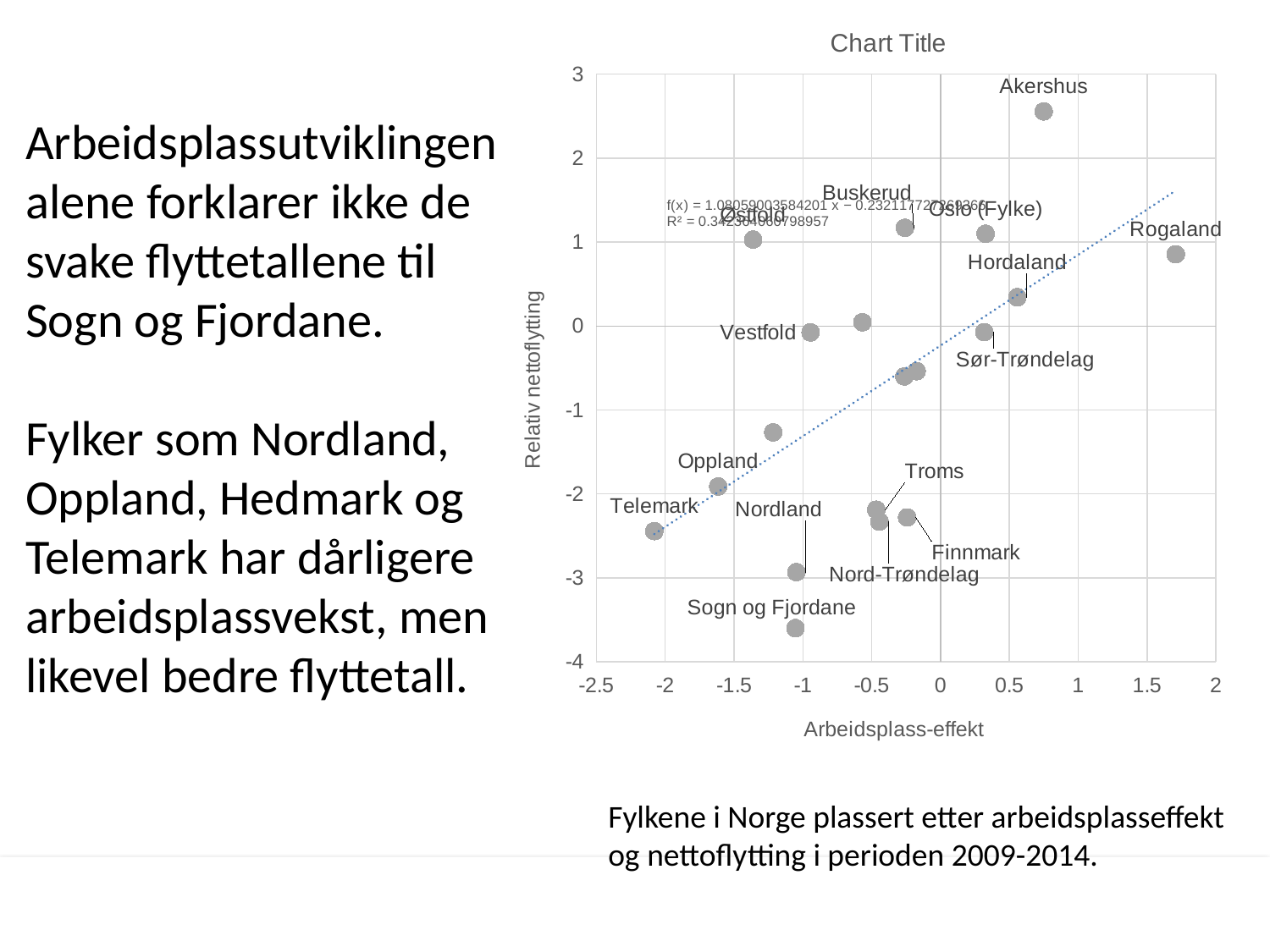
Which county has the lowest value on the Relativ nettoflytting axis? Sogn og Fjordane Do the points generally rise or fall as Arbeidsplass-effekt increases? Rise Is the Arbeidsplass-effekt value for Telemark greater or less than -2? less Which county has the lowest Arbeidsplass-effekt value? Telemark Is the Relativ nettoflytting value for Akershus greater or less than 2? greater Is the Relativ nettoflytting value for Sogn og Fjordane greater or less than -3? less Which county has the highest value on the Relativ nettoflytting axis? Akershus Which has the higher Relativ nettoflytting value, Akershus or Rogaland? Akershus What is the title of the horizontal axis of the chart? Arbeidsplass-effekt Which county has the highest Arbeidsplass-effekt value? Rogaland What kind of chart is shown on the slide? Scatter chart